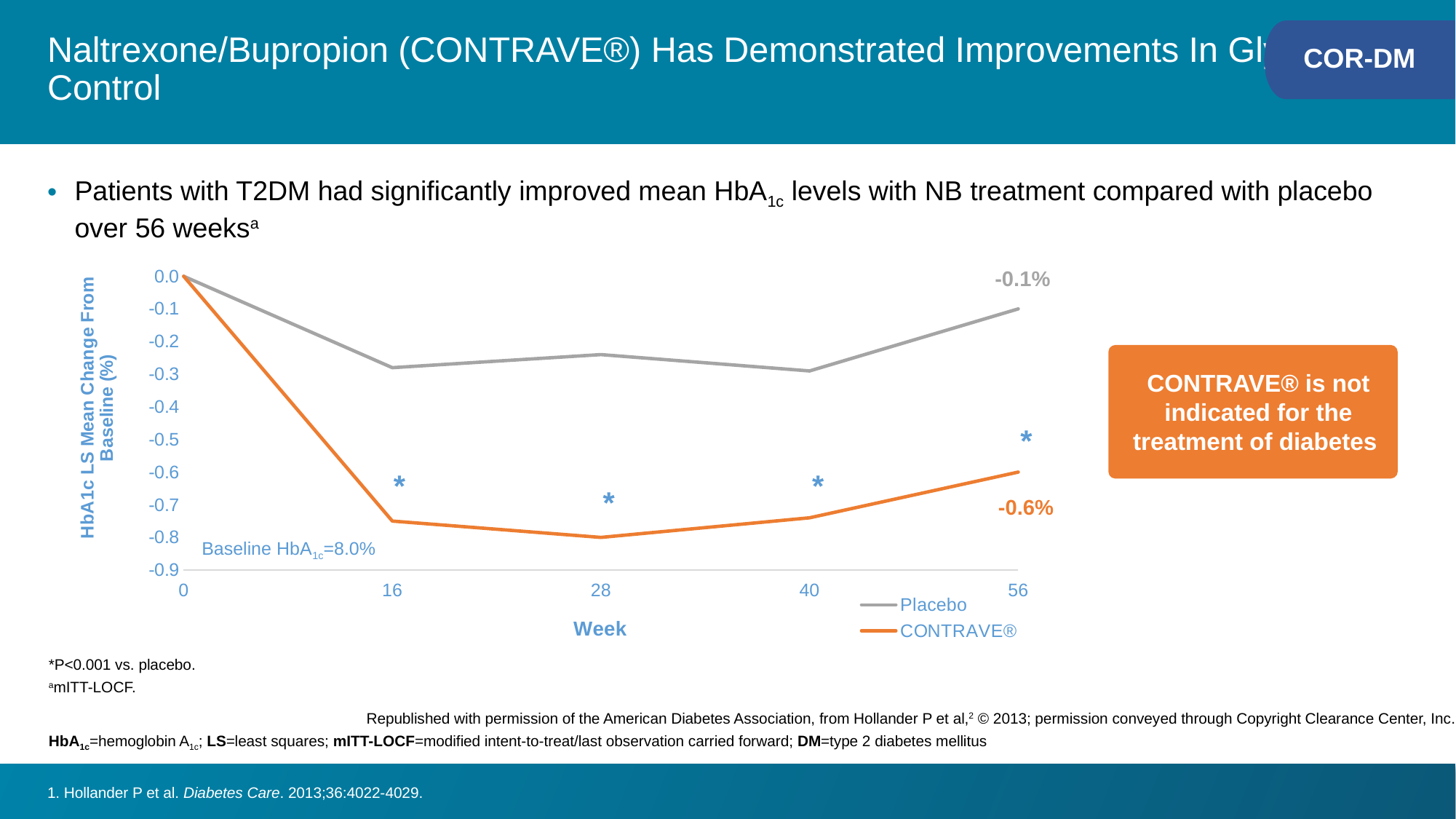
What is the difference between the Placebo and CONTRAVE® values at week 56? 0.5% Does the CONTRAVE® line rise or fall between week 28 and week 56? rise Is the value for CONTRAVE® at week 16 greater or less than -0.5? less What is the baseline HbA1c value noted on the chart? 8.0% How many series does the chart legend list? 2 What is the HbA1c LS mean change from baseline for Placebo at week 56? -0.1% How many week time points are plotted on the x axis? 5 At week 56, which series has the higher (less negative) value, Placebo or CONTRAVE®? Placebo What is the HbA1c LS mean change from baseline for CONTRAVE® at week 56? -0.6% What kind of chart is shown on the slide? line chart For the CONTRAVE® series, at which week is the value lowest? 28 Is the value for Placebo at week 16 greater or less than -0.5? greater